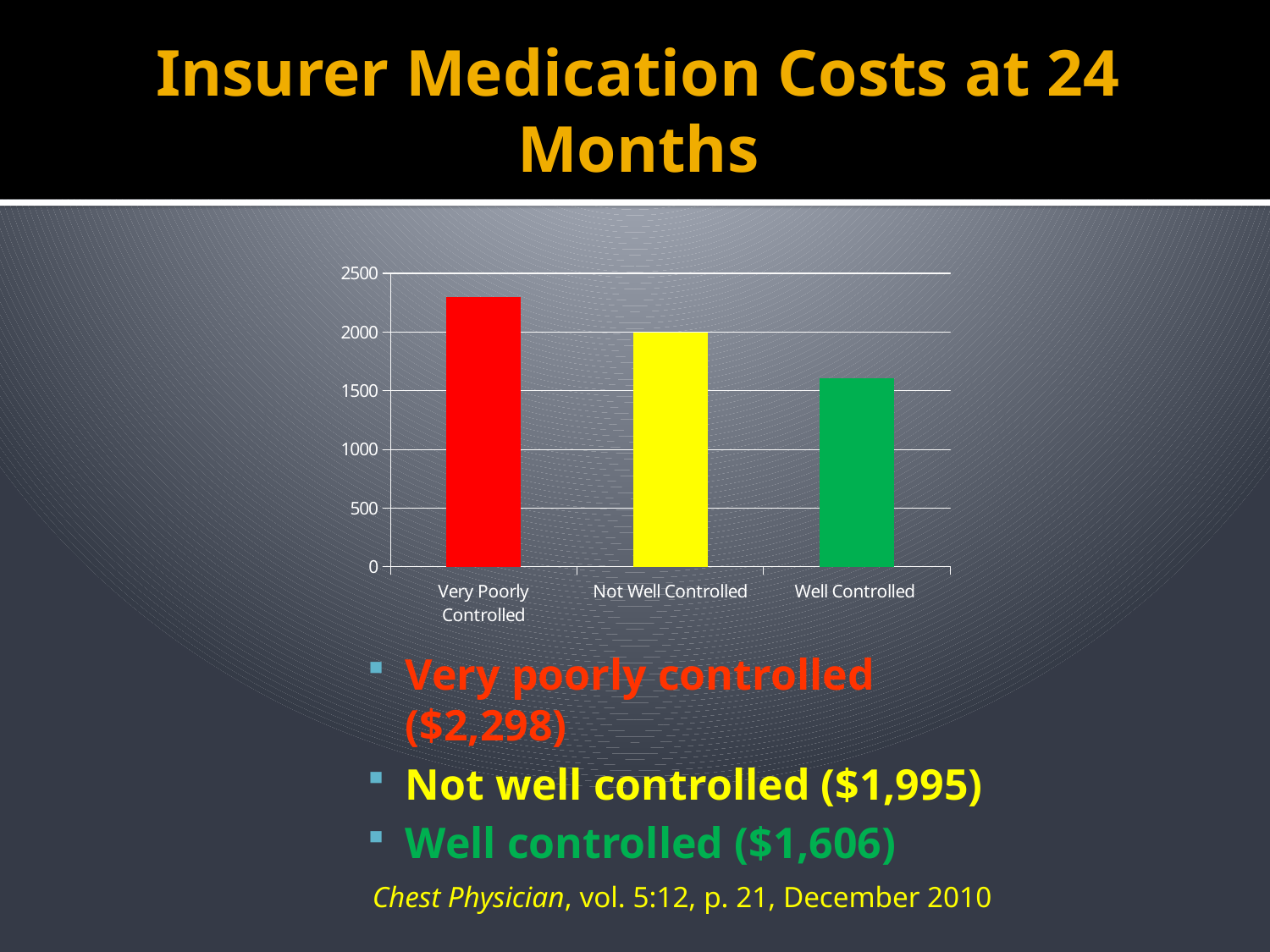
What kind of chart is shown on the slide? bar chart What is the insurer medication cost at 24 months for the Very Poorly Controlled group? $2,298 How many categories are plotted in the chart? 3 What is the insurer medication cost at 24 months for the Well Controlled group? $1,606 What is the insurer medication cost at 24 months for the Not Well Controlled group? $1,995 What is the difference in cost between the Not Well Controlled and Well Controlled groups? $389 Do the values rise or fall moving from left to right across the categories? fall Is the value for Very Poorly Controlled greater or less than 2000? greater What is the difference in cost between the Very Poorly Controlled and Well Controlled groups? $692 Which is larger, the cost for Not Well Controlled or for Well Controlled? Not Well Controlled Which category has the lowest insurer medication cost at 24 months? Well Controlled Which category has the highest insurer medication cost at 24 months? Very Poorly Controlled